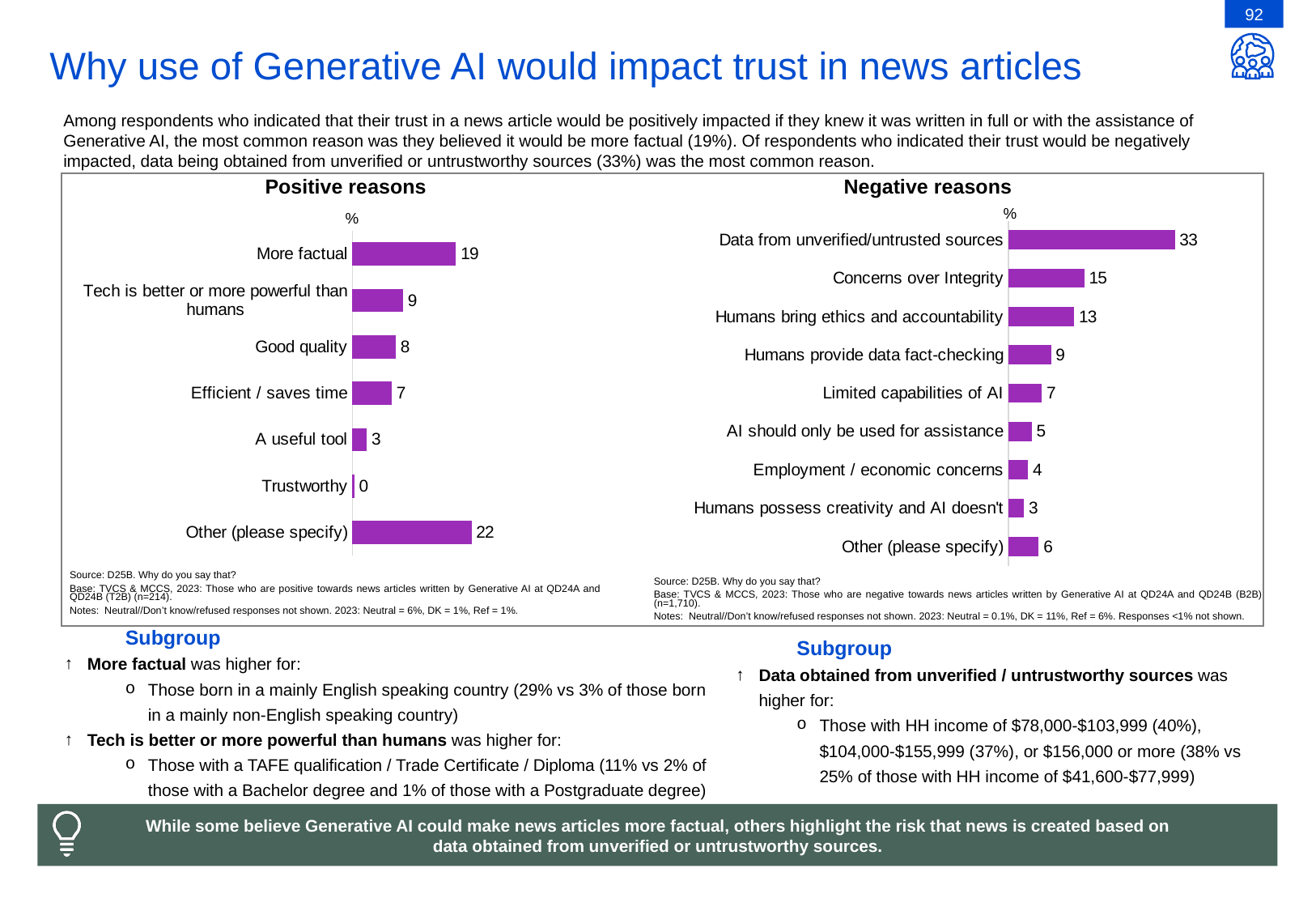
In the Positive reasons chart, which category has the highest value? Other (please specify) What kind of chart is the Negative reasons chart? Bar chart In the Positive reasons chart, what is the difference between More factual and Good quality? 11 In the Negative reasons chart, what is the difference between Data from unverified/untrusted sources and Concerns over Integrity? 18 In the Positive reasons chart, which category has the lowest value? Trustworthy In the Negative reasons chart, which is larger: Humans bring ethics and accountability or Humans provide data fact-checking? Humans bring ethics and accountability In the Negative reasons chart, which category has the lowest value? Humans possess creativity and AI doesn't In the Negative reasons chart, what is the value for Data from unverified/untrusted sources? 33 In the Positive reasons chart, what is the value for More factual? 19 In the Negative reasons chart, what is the value for Employment / economic concerns? 4 How many categories are shown in the Positive reasons chart? 7 How many categories are shown in the Negative reasons chart? 9